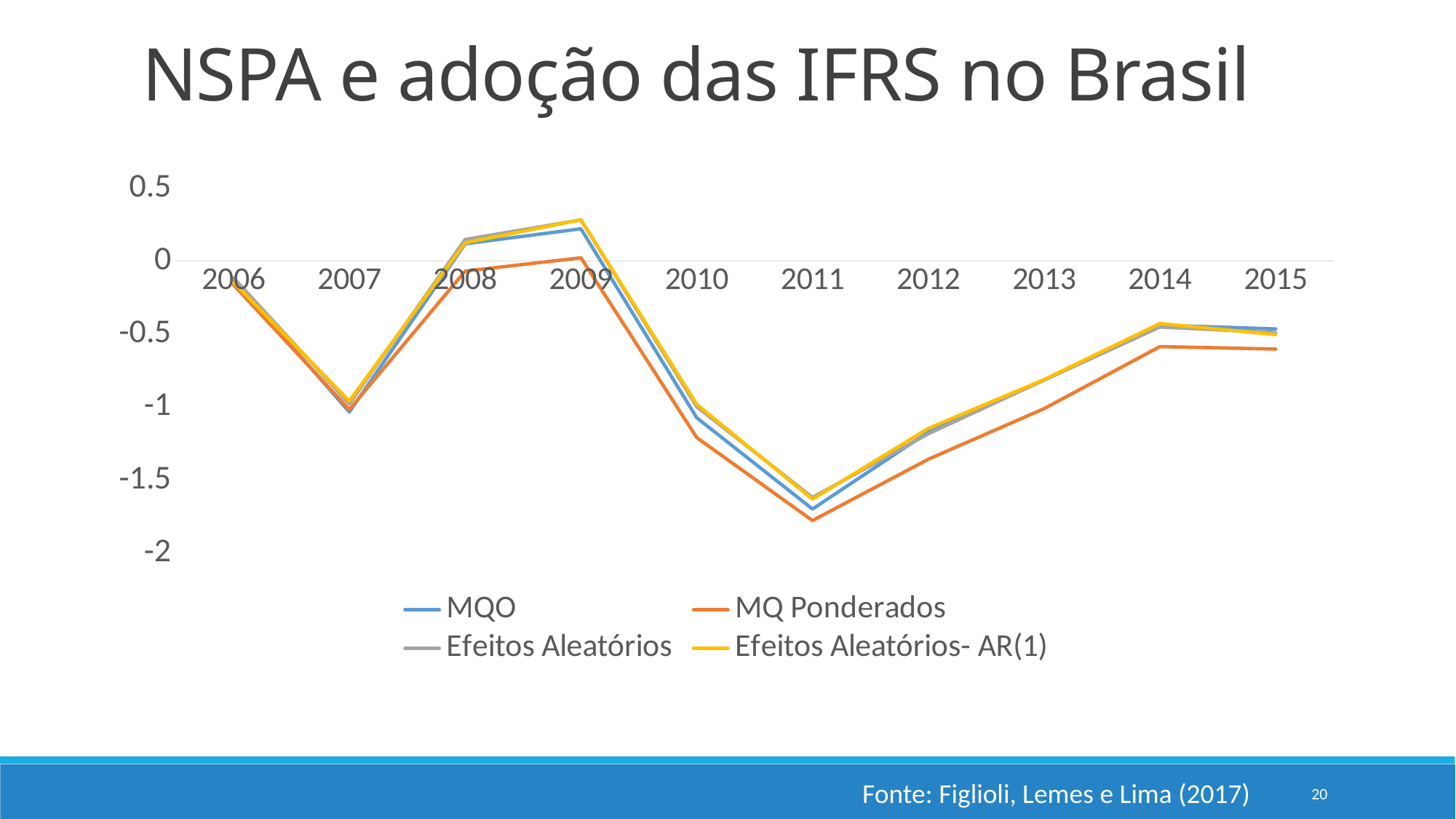
How many series does the legend list? 4 Is the value for MQ Ponderados in 2011 greater or less than -1.5? less Do the series values rise or fall from 2011 to 2014? rise In which year does the MQ Ponderados series reach its lowest value? 2011 In which year does the MQO series reach its highest value? 2009 What colour is the MQ Ponderados line in the legend? orange What kind of chart is shown on the slide? line chart In 2009, which series has the higher value, MQO or MQ Ponderados? MQO How many years are shown along the x axis? 10 Is the value for MQO in 2012 greater or less than -1? less Is the value for MQ Ponderados in 2015 greater or less than -0.5? less